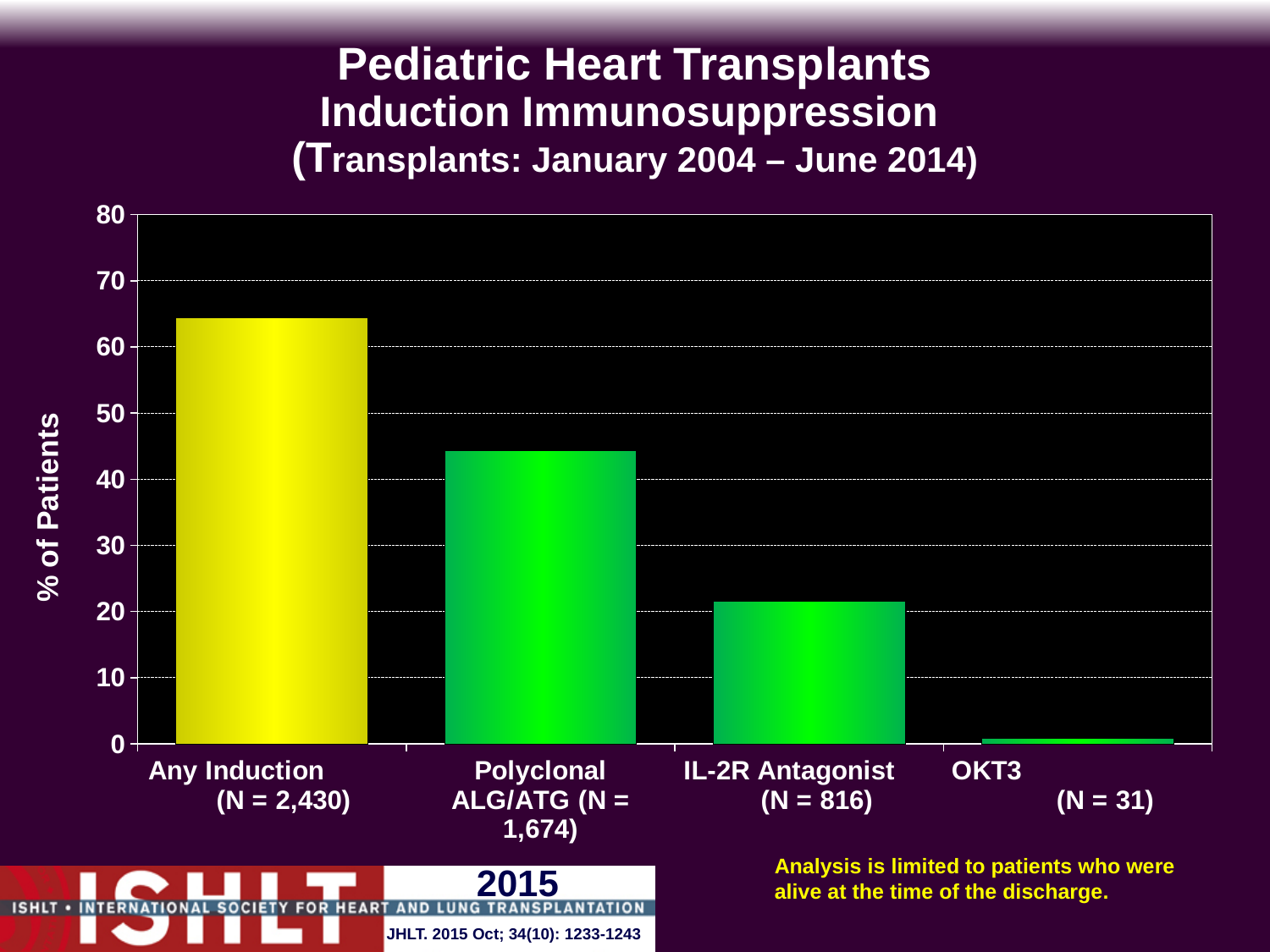
Is the value for OKT3 greater or less than 10? less Is the value for IL-2R Antagonist greater or less than 20? greater What is the N shown for the Any Induction category? N = 2,430 What is the label of the y axis? % of Patients What type of chart is shown on the slide? bar chart Do the values rise or fall moving from left to right across the categories? fall Is the value for Polyclonal ALG/ATG greater or less than 50? less Which category has the lowest percentage of patients? OKT3 Which is larger, the value for Polyclonal ALG/ATG or the value for IL-2R Antagonist? Polyclonal ALG/ATG How many categories are plotted on the chart? 4 Which category has the highest percentage of patients? Any Induction